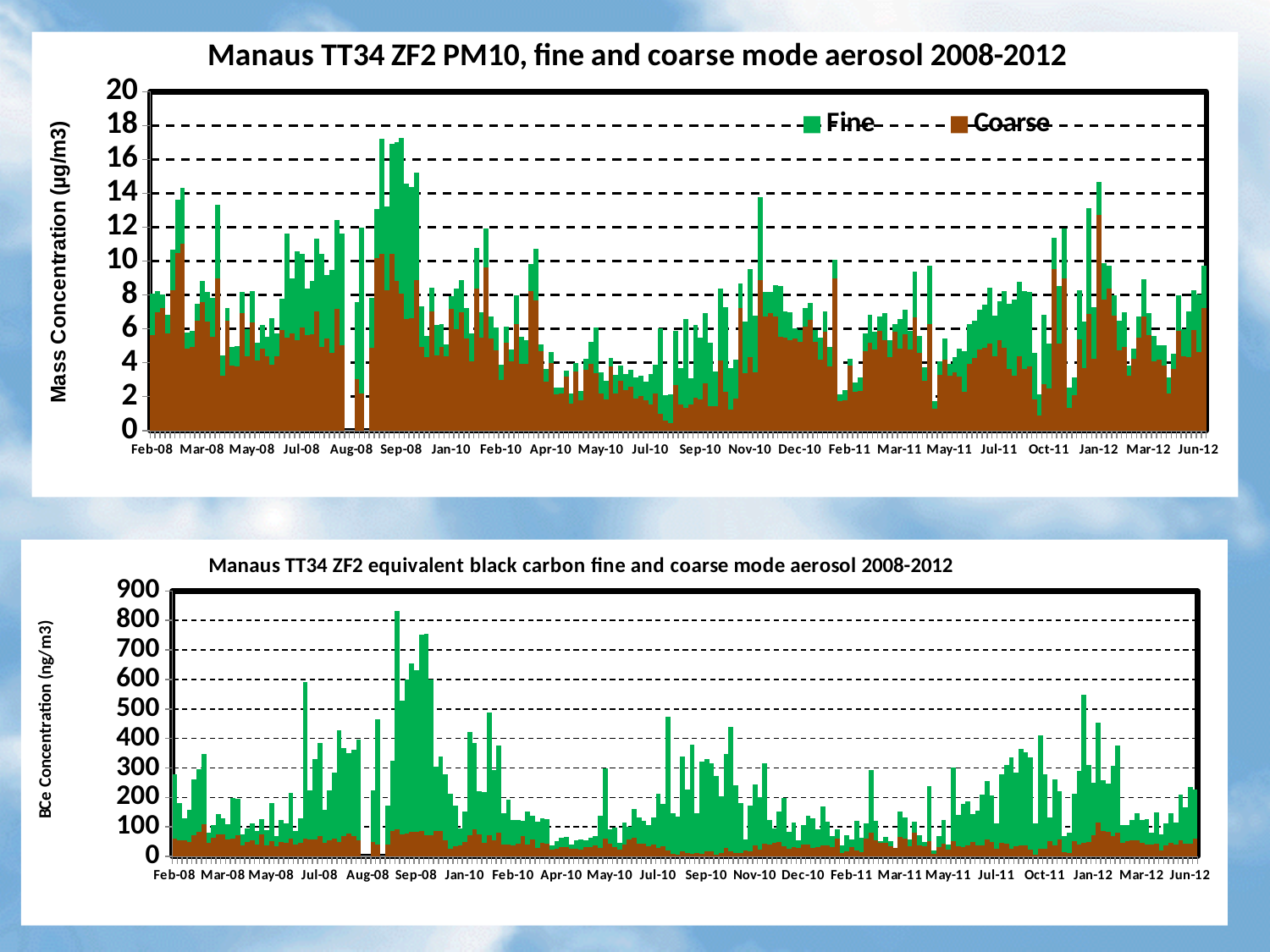
What kind of chart is the top chart on the slide? bar chart What is the y-axis label of the top chart? Mass Concentration (µg/m3) In the bottom chart, which series contributes more to the bars, Fine or Coarse? Fine How many series does the legend of the top chart list? 2 What is the highest tick value on the y axis of the bottom chart? 900 In the top chart, is the highest peak greater or less than 18? less In the top chart, is the highest peak (around Sep-08) greater or less than 16? greater In the bottom chart, is the highest peak greater or less than 900? less In the bottom chart, is the peak around Sep-08 higher or lower than the peak around Jan-12? higher In the top chart, is the peak around Sep-08 higher or lower than the peak around Jan-12? higher What are the two series named in the legend of the top chart? Fine and Coarse